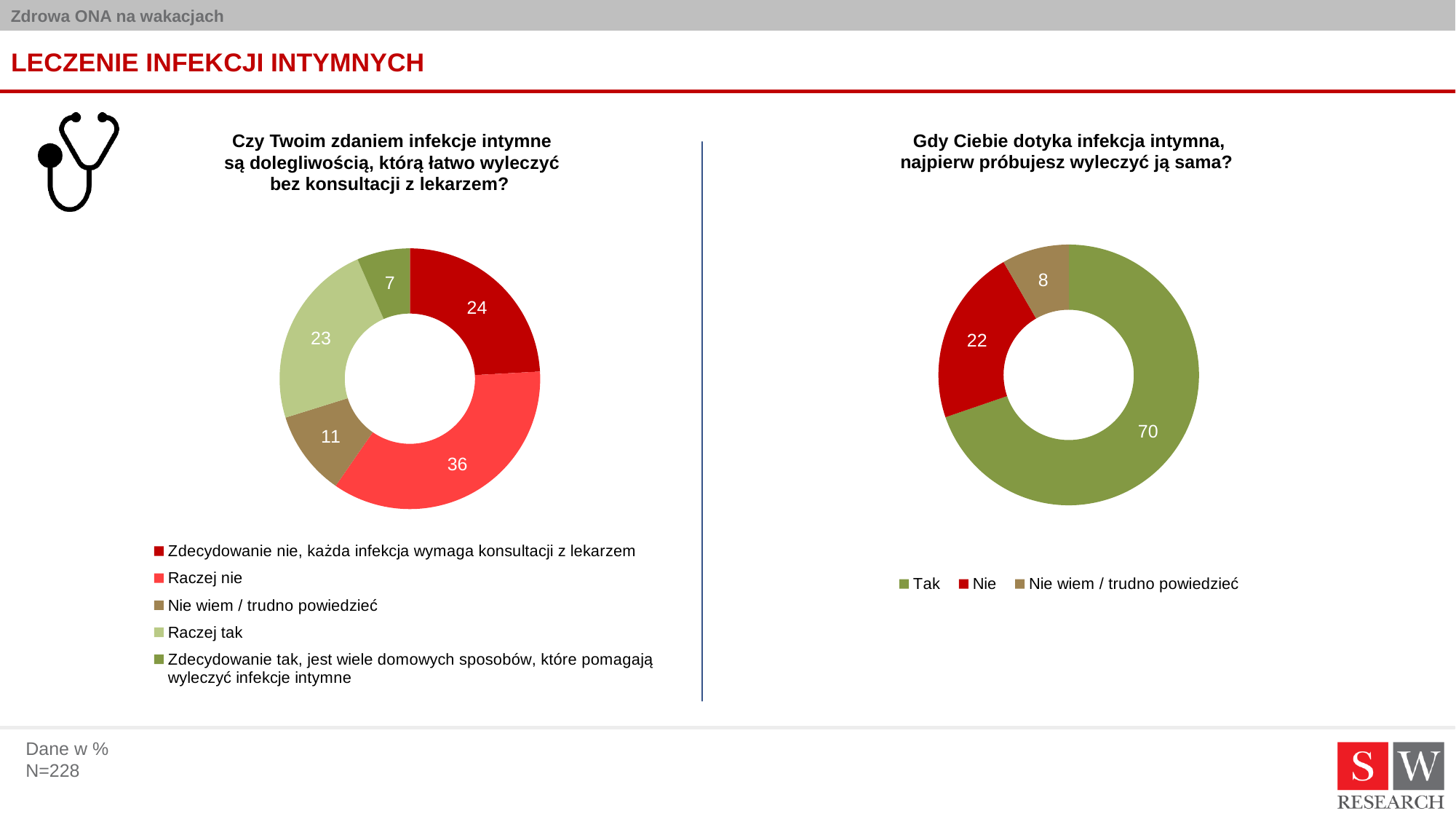
In the left chart, which category has the highest value? Raczej nie In the right chart, what is the value for "Nie wiem / trudno powiedzieć"? 8 In the right chart ("Gdy Ciebie dotyka infekcja intymna, najpierw próbujesz wyleczyć ją sama?"), what is the value for "Tak"? 70 In the left chart, what is the difference between "Raczej tak" and "Nie wiem / trudno powiedzieć"? 12 In the right chart, which is larger, "Nie" or "Nie wiem / trudno powiedzieć"? Nie In the right chart, what is the difference between "Tak" and "Nie"? 48 In the left chart, how many categories are shown? 5 What type of chart is the right chart? Donut chart In the left chart, which category has the lowest value? Zdecydowanie tak, jest wiele domowych sposobów, które pomagają wyleczyć infekcje intymne How many entries does the legend of the right chart list? 3 In the left chart ("Czy Twoim zdaniem infekcje intymne są dolegliwością, którą łatwo wyleczyć bez konsultacji z lekarzem?"), what is the value for "Raczej nie"? 36 In the left chart, what is the value for "Zdecydowanie nie, każda infekcja wymaga konsultacji z lekarzem"? 24